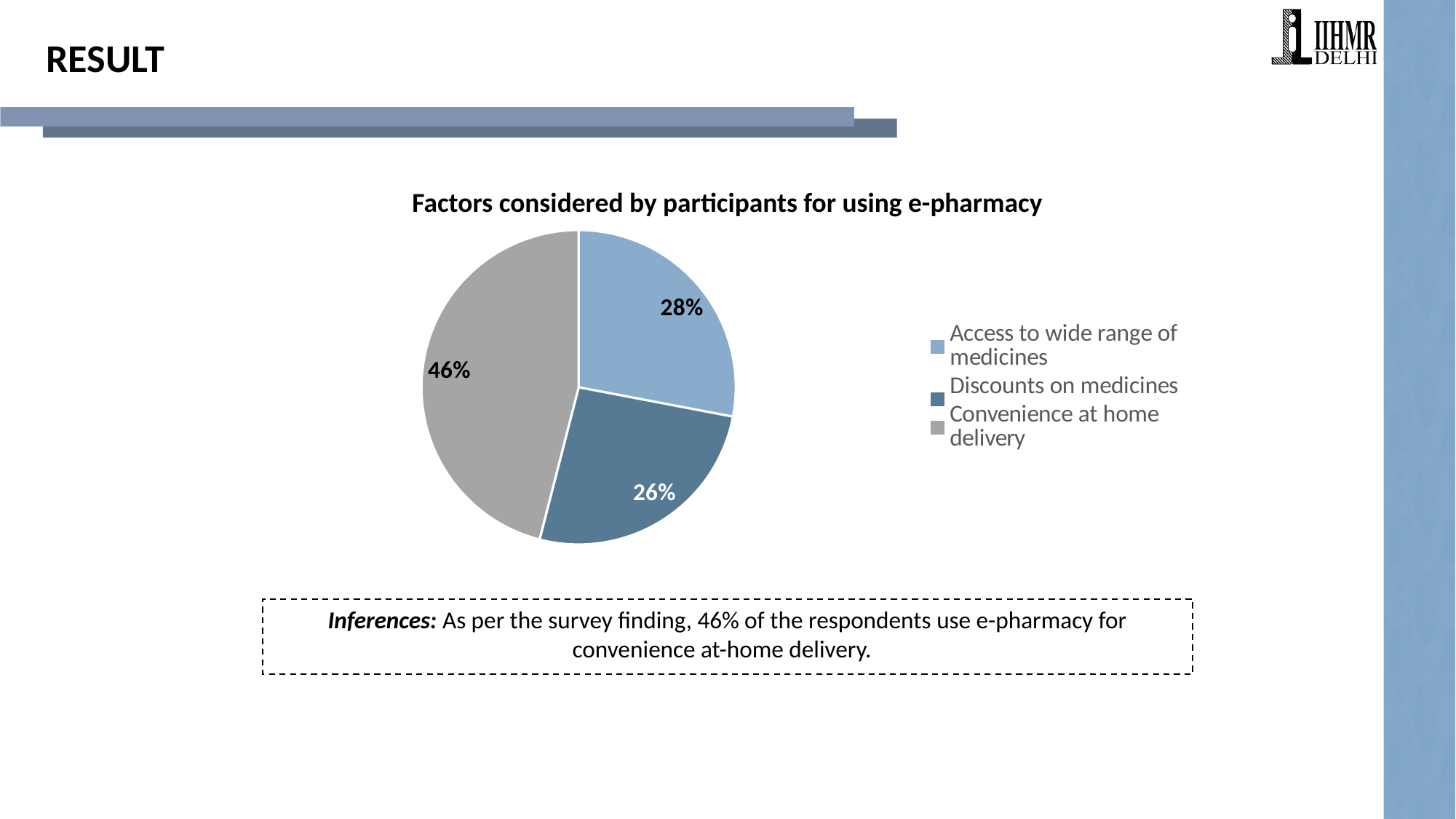
How many slices does the pie chart have? 3 What kind of chart is shown on the slide? Pie chart What share of the pie is 'Discounts on medicines'? 26% What is the difference in percentage points between 'Convenience at home delivery' and 'Access to wide range of medicines'? 18 percentage points What share of the pie is 'Convenience at home delivery'? 46% Which is larger: the share for 'Access to wide range of medicines' or the share for 'Discounts on medicines'? Access to wide range of medicines How many entries does the legend list? 3 Which factor has the largest share of the pie? Convenience at home delivery What is the title of the chart? Factors considered by participants for using e-pharmacy What colour is the slice for 'Convenience at home delivery'? Grey Which factor has the smallest share of the pie? Discounts on medicines What share of the pie is 'Access to wide range of medicines'? 28%